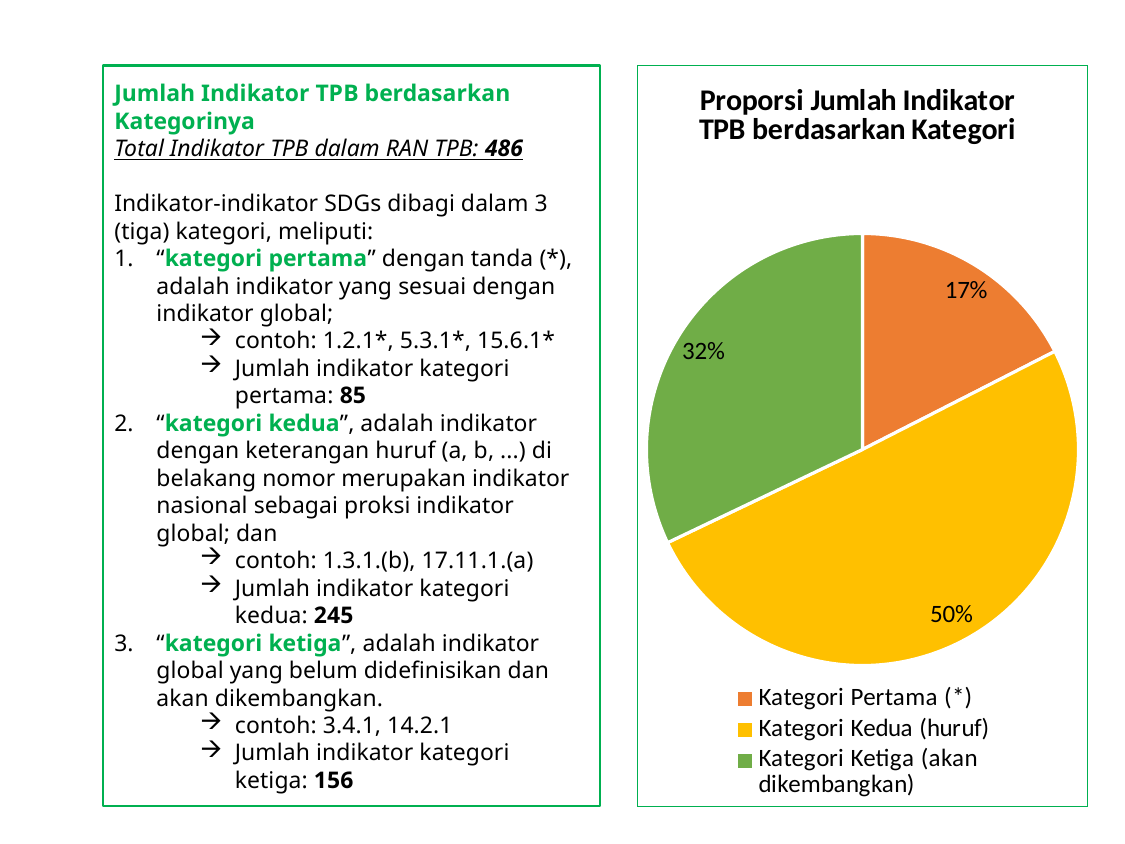
How many entries does the legend list? 3 What colour is the slice for Kategori Kedua (huruf)? yellow What kind of chart is shown on the slide? pie chart What share of the pie does Kategori Kedua (huruf) have? 50% What share of the pie does Kategori Ketiga (akan dikembangkan) have? 32% What share of the pie does Kategori Pertama (*) have? 17% How many slices does the pie chart have? 3 What is the difference in percentage points between Kategori Kedua (huruf) and Kategori Ketiga (akan dikembangkan)? 18% Which category has the smallest slice of the pie? Kategori Pertama (*) What is the title of the chart? Proporsi Jumlah Indikator TPB berdasarkan Kategori Which category has the largest slice of the pie? Kategori Kedua (huruf) Which is larger, the slice for Kategori Ketiga (akan dikembangkan) or the slice for Kategori Pertama (*)? Kategori Ketiga (akan dikembangkan)